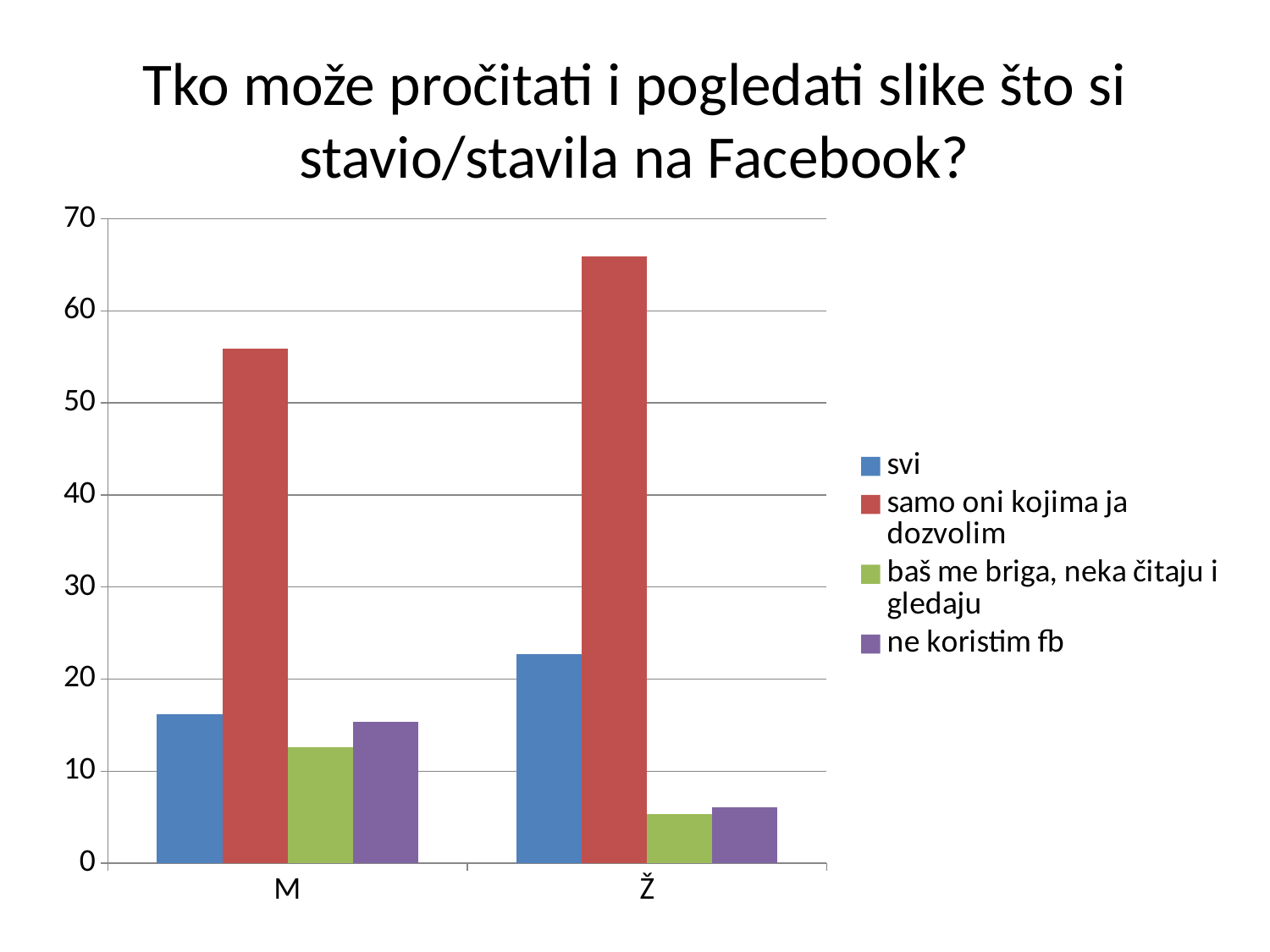
Which series has the highest value for category M? samo oni kojima ja dozvolim Is the value for 'svi' in category Ž greater or less than 20? greater Is the value for 'samo oni kojima ja dozvolim' in category M greater or less than 60? less Is the value for 'baš me briga, neka čitaju i gledaju' in category Ž greater or less than 10? less What is the title of the chart? Tko može pročitati i pogledati slike što si stavio/stavila na Facebook? Which is larger: the value for 'svi' in category M or the value for 'svi' in category Ž? Ž Which series has the lowest value for category M? baš me briga, neka čitaju i gledaju Which series has the highest value for category Ž? samo oni kojima ja dozvolim What kind of chart is shown on the slide? bar chart How many series does the legend list? 4 How many categories are shown on the x axis? 2